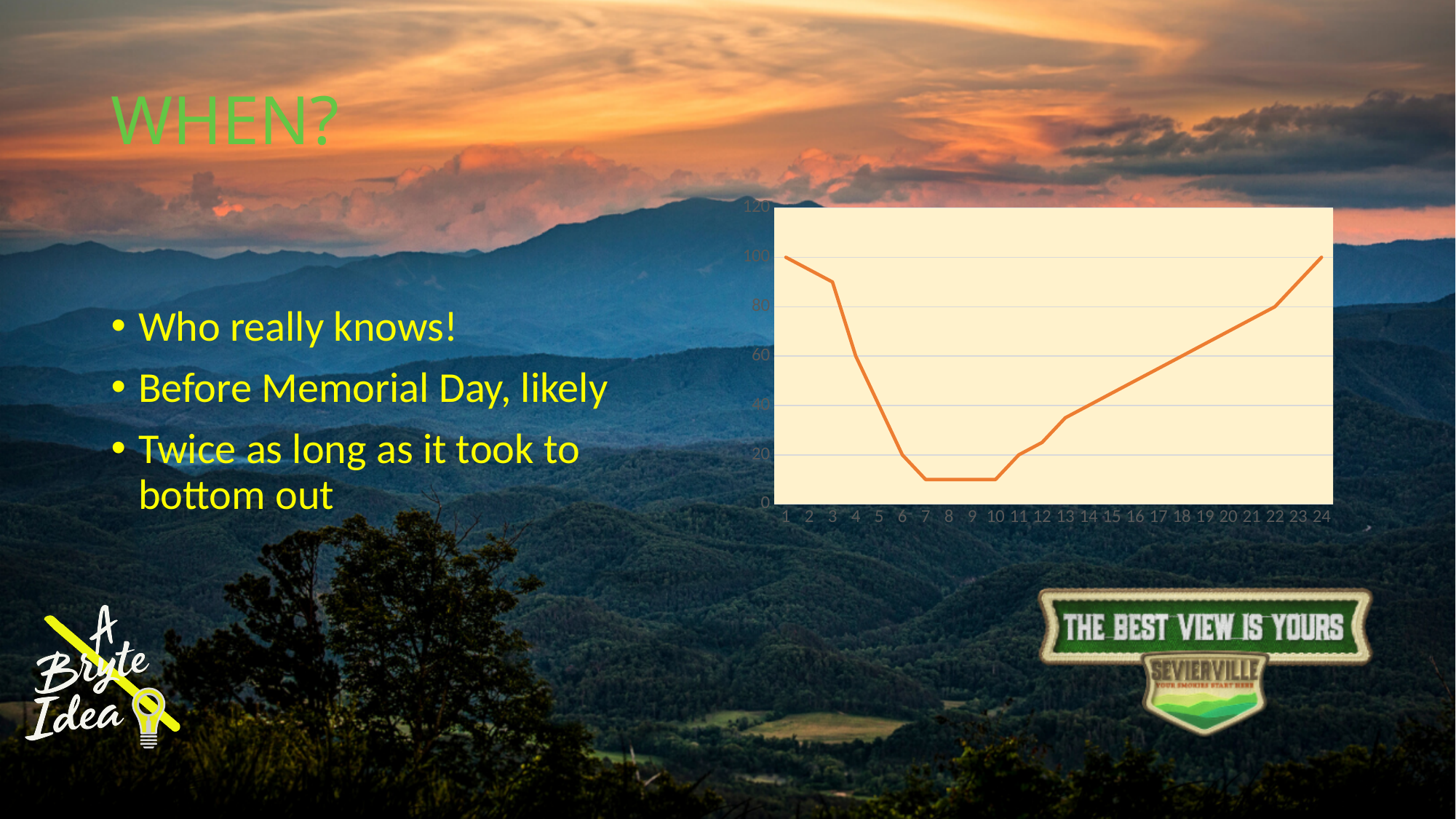
What is the value at x = 1 on the chart? 100 What kind of chart is shown on the slide? line chart Do the values rise or fall from x = 1 to x = 7? fall What is the value at x = 24 on the chart? 100 What is the value at x = 22 on the chart? 80 Is the value at x = 7 greater or less than 20? less Do the values rise or fall from x = 10 to x = 24? rise What colour is the line plotted on the chart? orange Is the value at x = 3 greater or less than 80? greater Is the value at x = 19 greater or less than 60? greater How many points are plotted along the x axis of the chart? 24